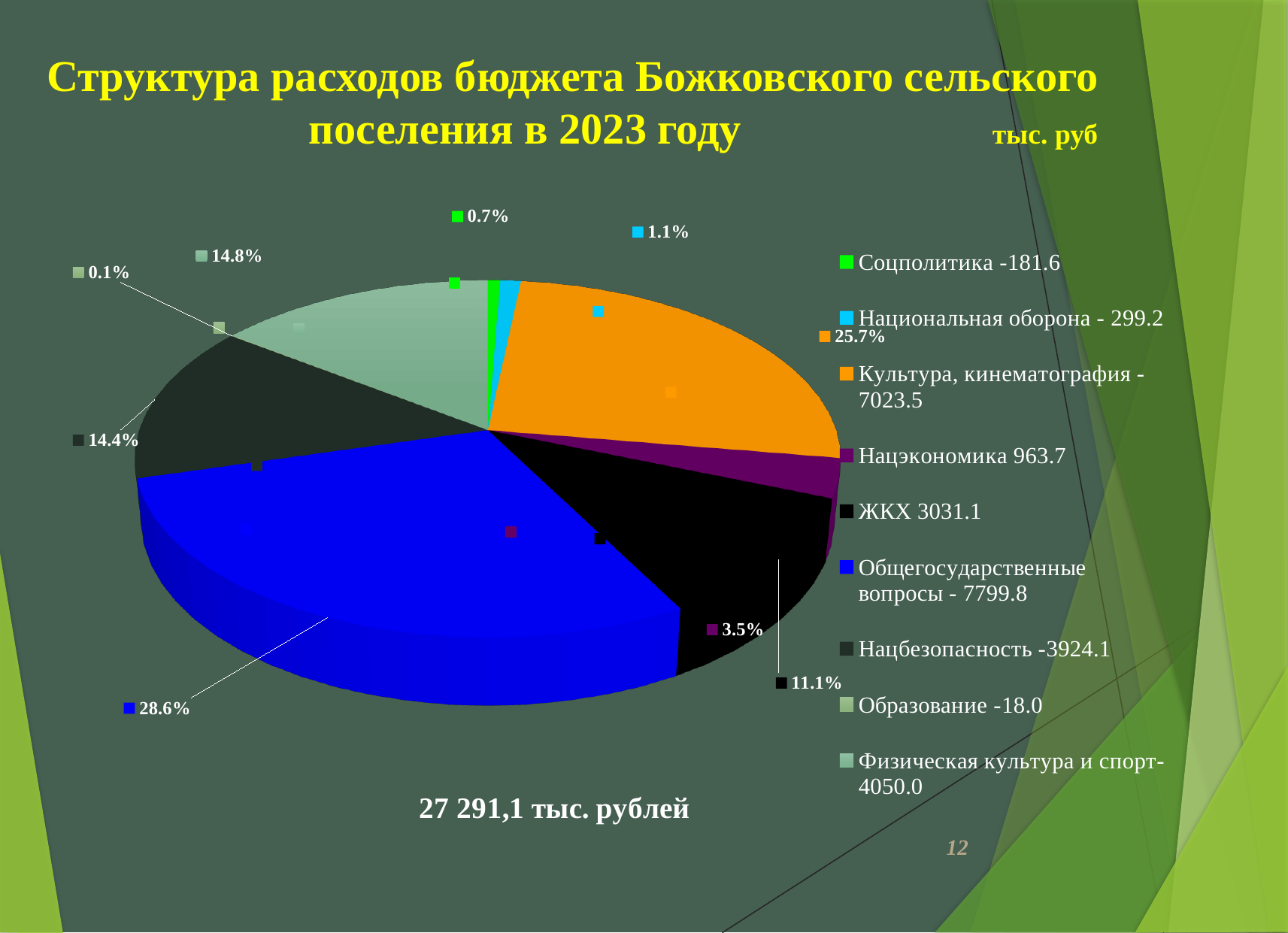
How many categories does the pie chart have? 9 What is the difference in percentage points between the shares of Общегосударственные вопросы and Культура, кинематография? 2.9% What share of the pie does ЖКХ have? 11.1% Which category has the largest share of the pie? Общегосударственные вопросы What value is given for Физическая культура и спорт in the legend? 4050.0 Which is larger, the share for Нацэкономика or the share for Национальная оборона? Нацэкономика What share of the pie does Культура, кинематография have? 25.7% What value is given for Общегосударственные вопросы in the legend? 7799.8 What share of the pie does Нацбезопасность have? 14.4% What kind of chart is shown on the slide? pie chart What total amount is shown below the pie chart? 27 291,1 тыс. рублей Which category has the smallest share of the pie? Образование